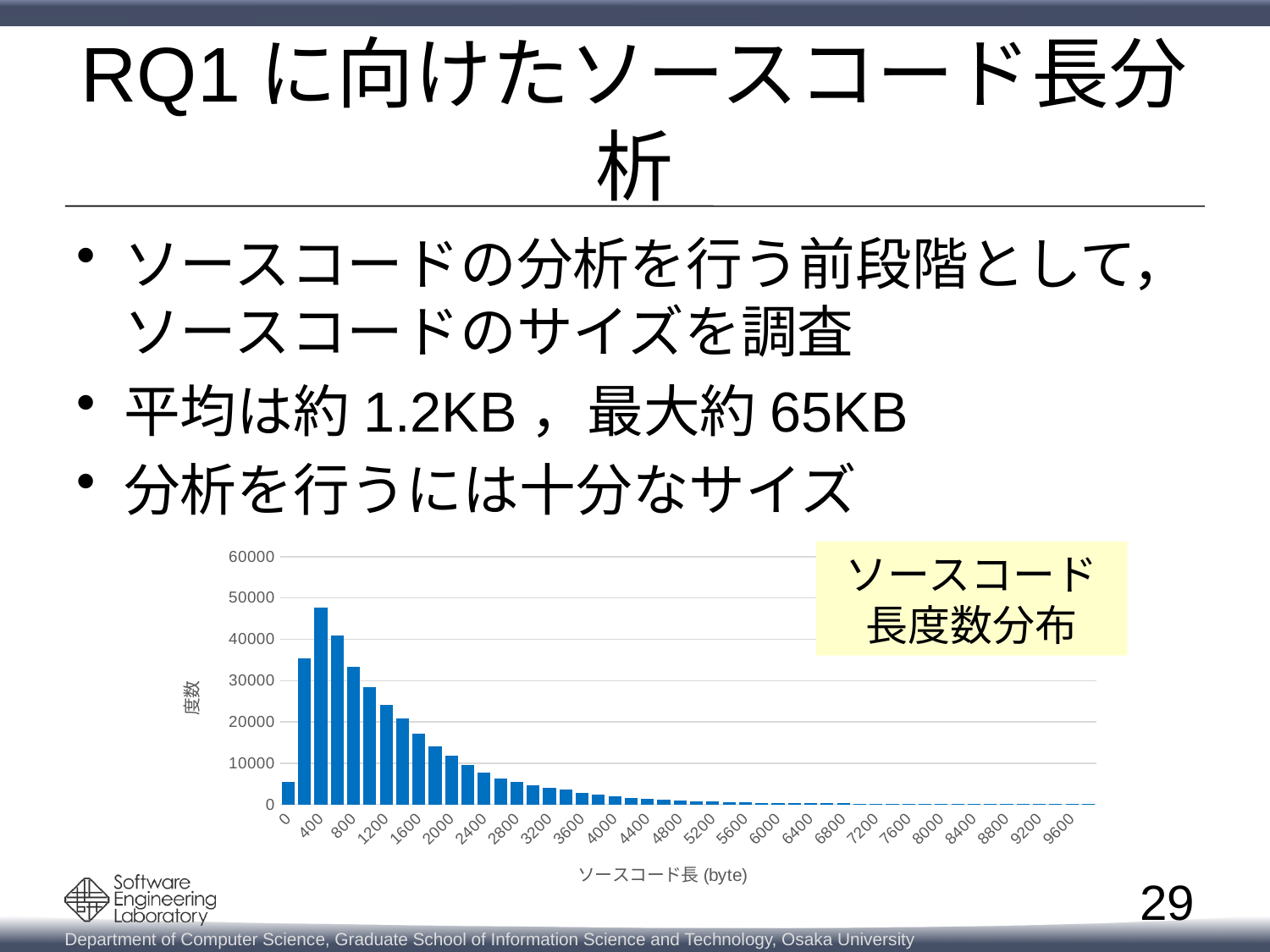
Is the value for 1600 greater or less than 20000? less What is the title shown in the yellow box next to the chart? ソースコード長度数分布 Is the value for 400 greater or less than 40000? greater What kind of chart is shown on the slide? bar chart Is the value for 4000 greater or less than 10000? less Which has the larger value, 400 or 800? 400 At which x-axis label does the tallest bar appear? 400 After the peak at 400, do the values rise or fall as source code length increases along the x axis? fall What is the label of the x axis of the chart? ソースコード長 (byte)